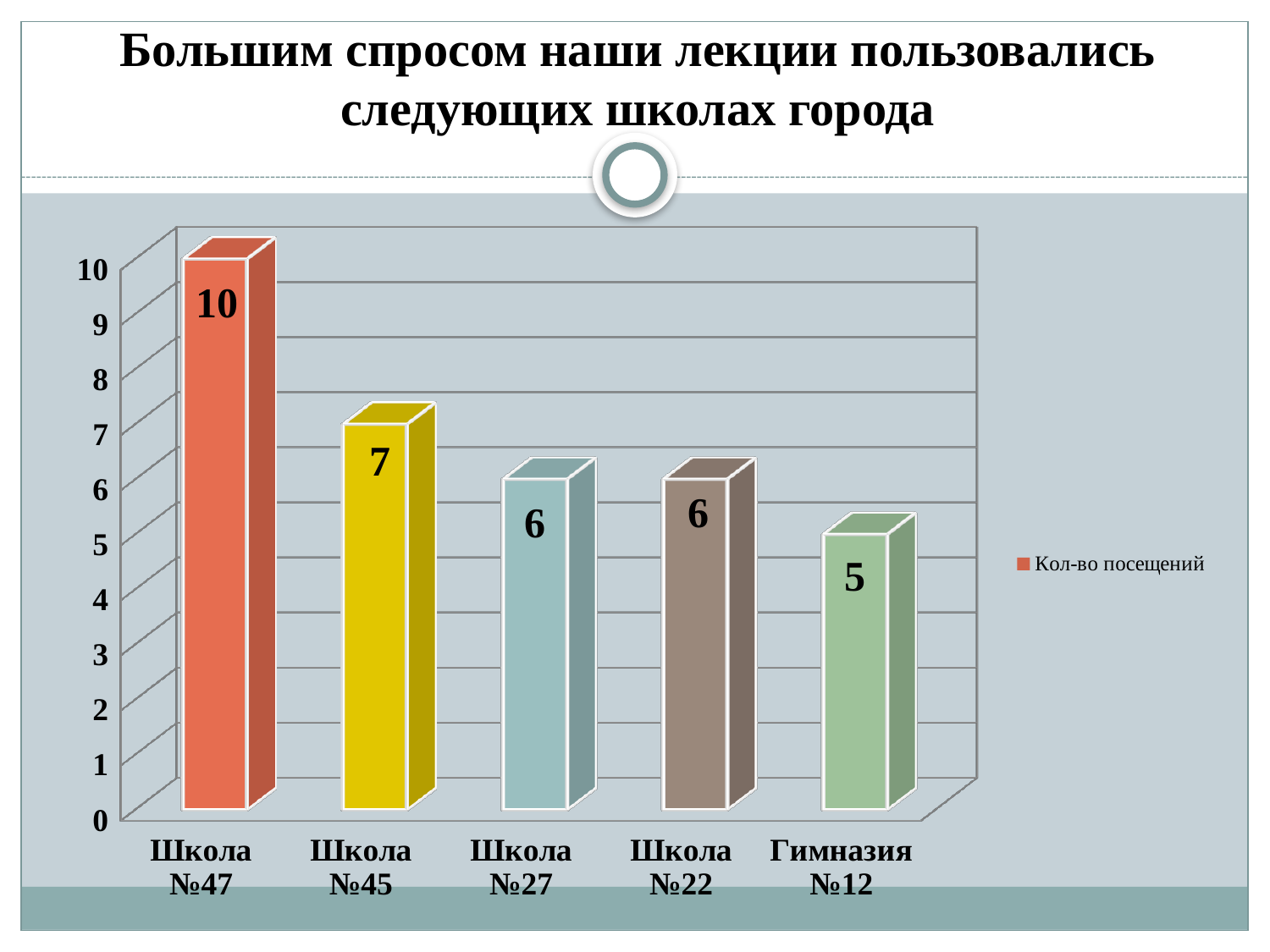
What kind of chart is shown on the slide? Bar chart Which category has the lowest value? Гимназия №12 What is the value for Школа №45? 7 How many series does the legend list? 1 What is the difference between the values for Школа №27 and Гимназия №12? 1 Which school has the highest value? Школа №47 Which is larger, the value for Школа №45 or the value for Школа №22? Школа №45 What is the value for Школа №47? 10 What is the value for Гимназия №12? 5 What is the legend entry for the series? Кол-во посещений How many categories are shown on the x axis? 5 What is the difference between the values for Школа №47 and Школа №45? 3